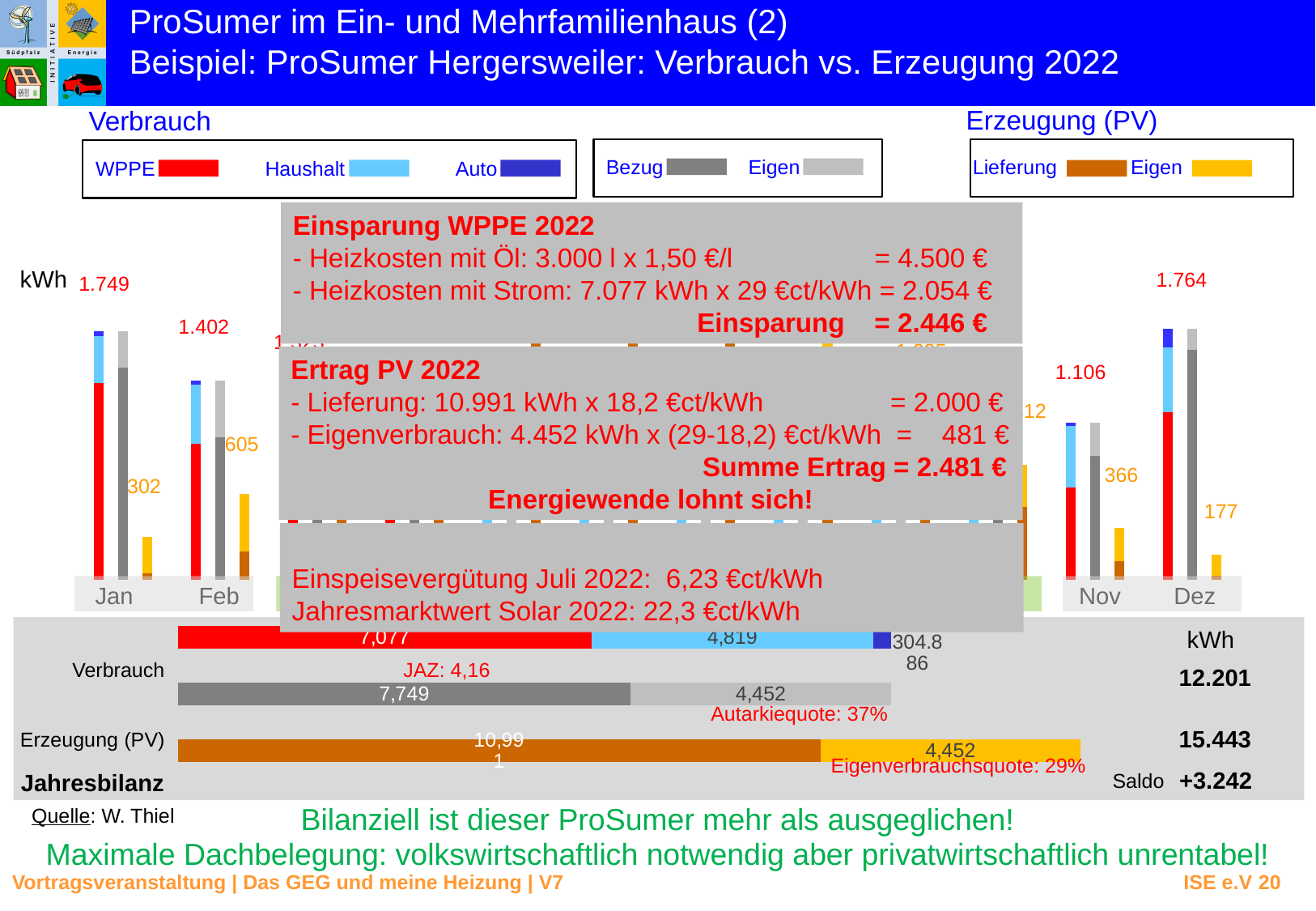
In the Jahresbilanz bars, what is the value of the Lieferung segment of Erzeugung (PV)? 10,991 In the monthly chart, what is the Verbrauch value labelled for Jan? 1.749 In the Jahresbilanz, what is the total Erzeugung (PV) in kWh? 15.443 In the Jahresbilanz, what is the Saldo shown? +3.242 In the monthly chart, what is the PV (Erzeugung) value labelled for Feb? 605 How many series does the Verbrauch legend list? 3 In the monthly chart, what is the PV (Erzeugung) value labelled for Nov? 366 What kind of chart is the monthly Verbrauch vs. Erzeugung chart? bar chart In the monthly chart, which month has the higher labelled Verbrauch value, Jan or Dez? Dez In the monthly chart, what is the difference between the PV values labelled for Feb (605) and Jan (302)? 303 In the Jahresbilanz bars, what is the value of the Bezug segment? 7,749 In the monthly chart, what is the Verbrauch value labelled for Dez? 1.764